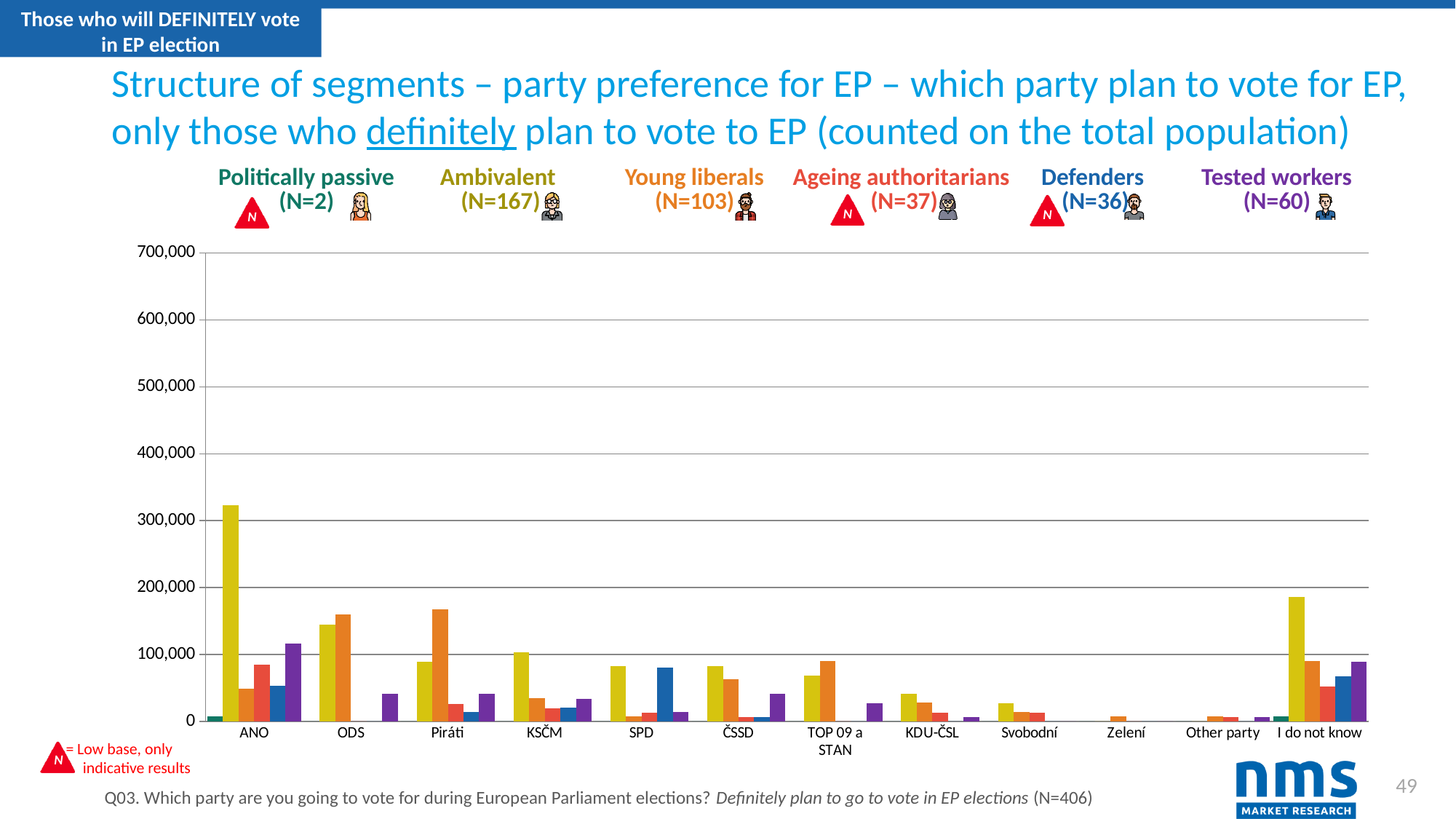
For Piráti, which segment has the larger bar: Ambivalent or Young liberals? Young liberals What kind of chart is shown on the slide? bar chart Is the Defenders value for SPD greater or less than 100,000? less Which is larger for the Ambivalent segment: the value for ANO or the value for ODS? ANO For which party is the Ambivalent segment's bar the highest? ANO Is the Ambivalent value for ANO greater or less than 300,000? greater Is the Ambivalent value for 'I do not know' greater or less than 200,000? less How many segments (series) does the legend above the chart list? 6 What is the sample size (N) shown for the Ambivalent segment in the legend? N=167 How many party categories are shown along the x axis of the chart? 12